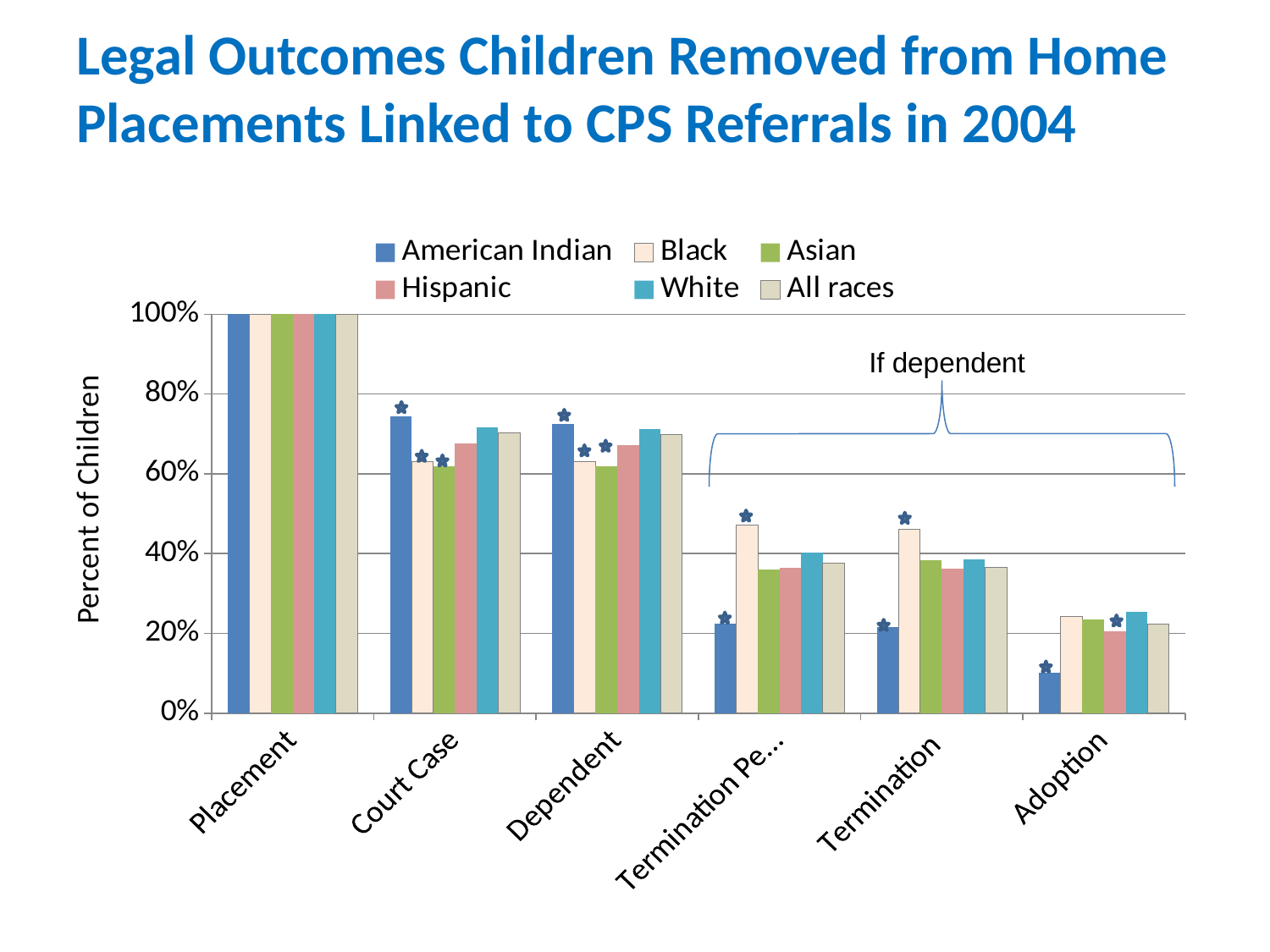
How many series does the legend list? 6 Is the value for American Indian in the Adoption category greater or less than 20%? less In the Adoption category, which is larger: American Indian or White? White What is the label on the vertical axis? Percent of Children Which series has the lowest value in the Adoption category? American Indian Is the value for Black in the Termination category greater or less than 40%? greater Which series has the highest value in the Termination category? Black Is the value for American Indian in the Court Case category greater or less than 60%? greater What is the value for American Indian in the Placement category? 100% How many categories are shown along the x axis? 6 What kind of chart is shown on the slide? bar chart In the Court Case category, which is larger: American Indian or Black? American Indian